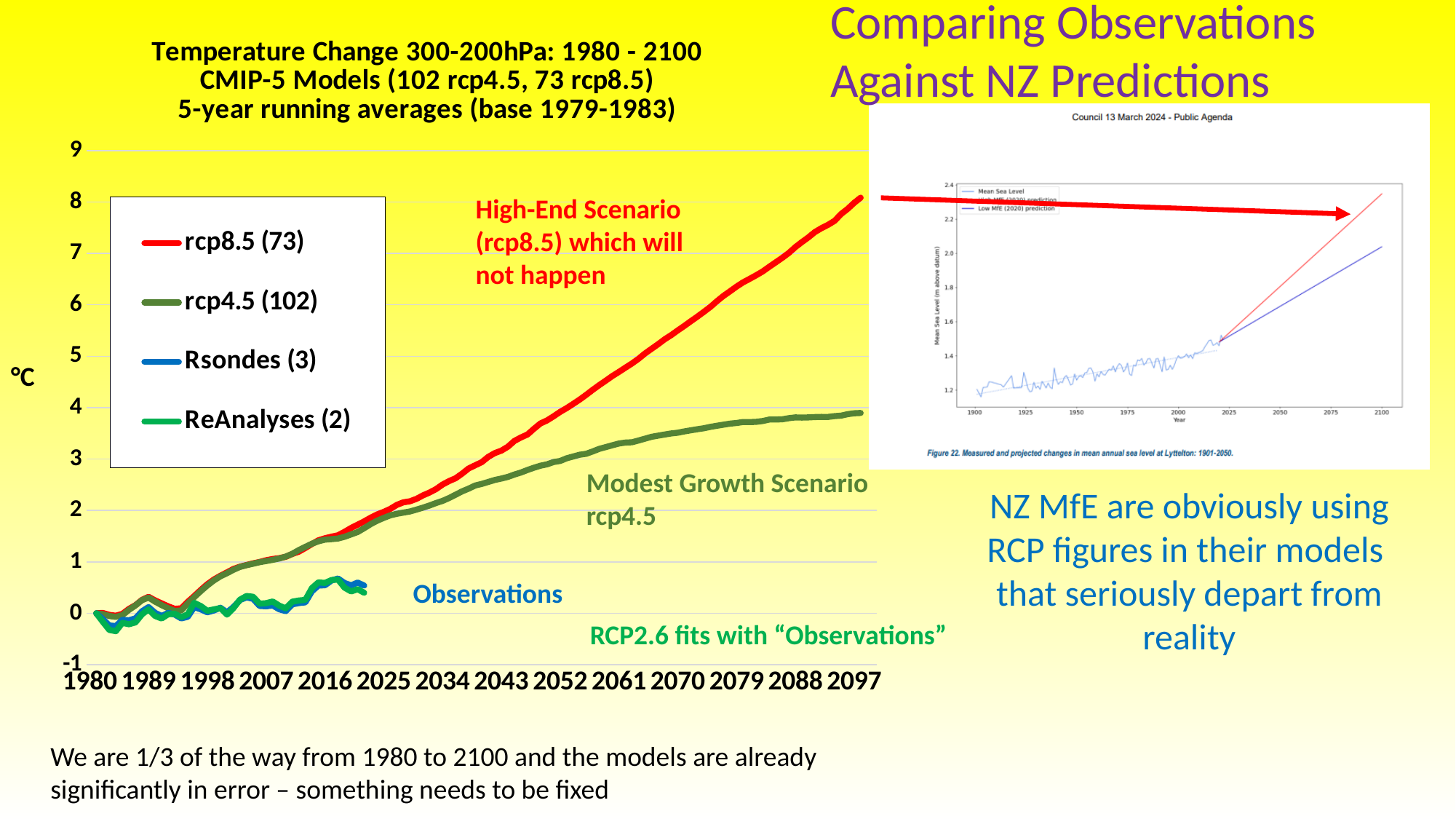
How many series does the legend of the temperature change chart list? 4 How many series does the legend of the sea level chart on the right list? 3 What unit is shown on the y axis of the temperature change chart? °C What type of chart is the temperature change chart on the left of the slide? line chart In the temperature change chart, is the rcp8.5 (73) value at 2097 greater or less than 7? greater In the temperature change chart, is the rcp4.5 (102) value at 2097 greater or less than 3? greater In the temperature change chart, is the rcp8.5 (73) value at 2070 greater or less than 5? greater In the temperature change chart, which is larger at 2097: rcp8.5 (73) or rcp4.5 (102)? rcp8.5 (73) In the temperature change chart, does the rcp8.5 (73) series rise or fall from 1980 to 2097? rise In the temperature change chart, which series has the highest value at 2097? rcp8.5 (73)